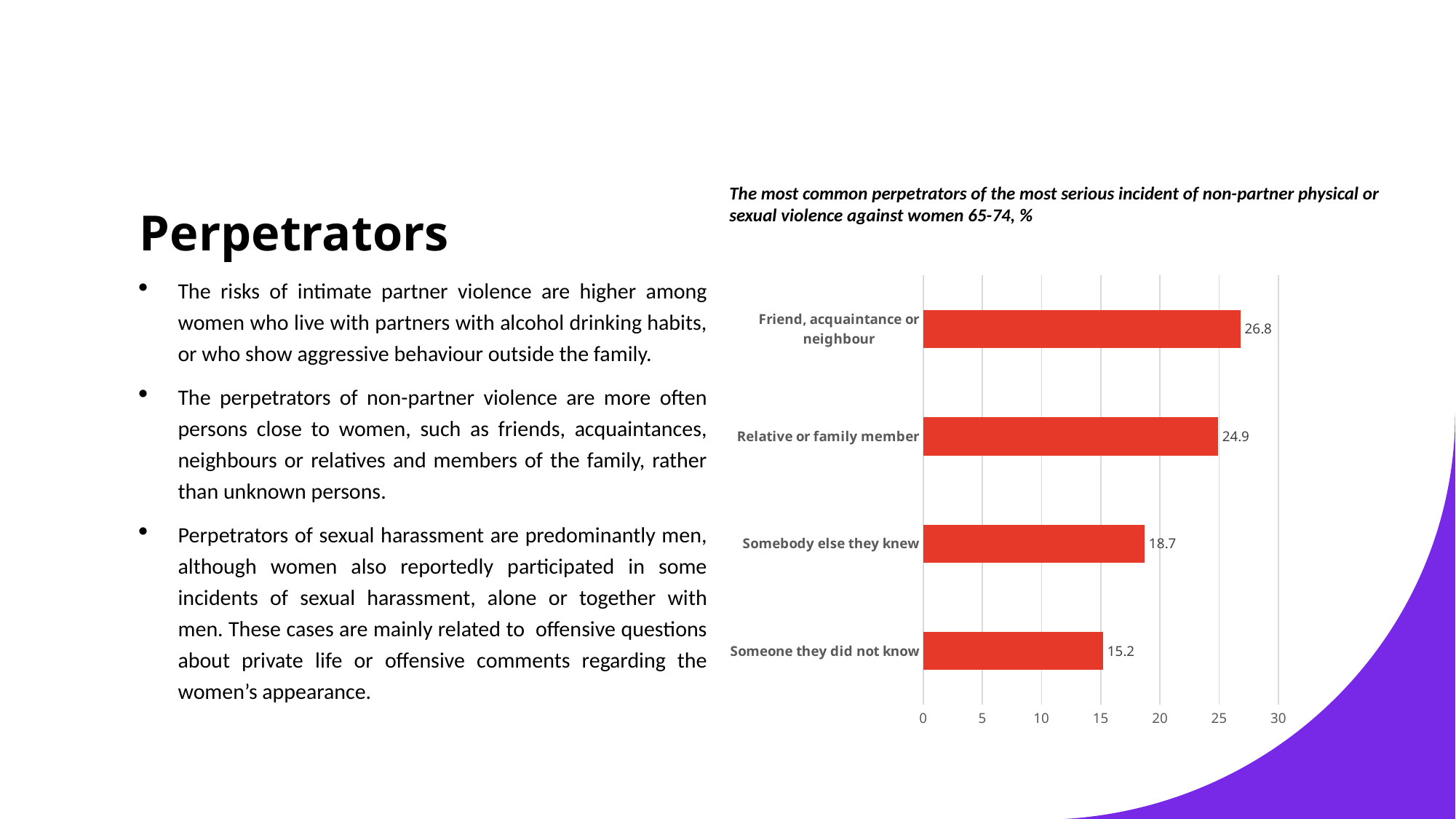
What kind of chart is shown on the slide? Bar chart What is the value for 'Someone they did not know'? 15.2 Which category has the lowest value? Someone they did not know Which category has the highest value? Friend, acquaintance or neighbour How many categories are shown in the chart? 4 Which is larger: the value for 'Relative or family member' or 'Somebody else they knew'? Relative or family member Is the value for 'Somebody else they knew' greater or less than 20? less What is the value for 'Friend, acquaintance or neighbour'? 26.8 What is the value for 'Somebody else they knew'? 18.7 What is the value for 'Relative or family member'? 24.9 What is the title of the chart? The most common perpetrators of the most serious incident of non-partner physical or sexual violence against women 65-74, % What is the difference between the values for 'Friend, acquaintance or neighbour' and 'Someone they did not know'? 11.6